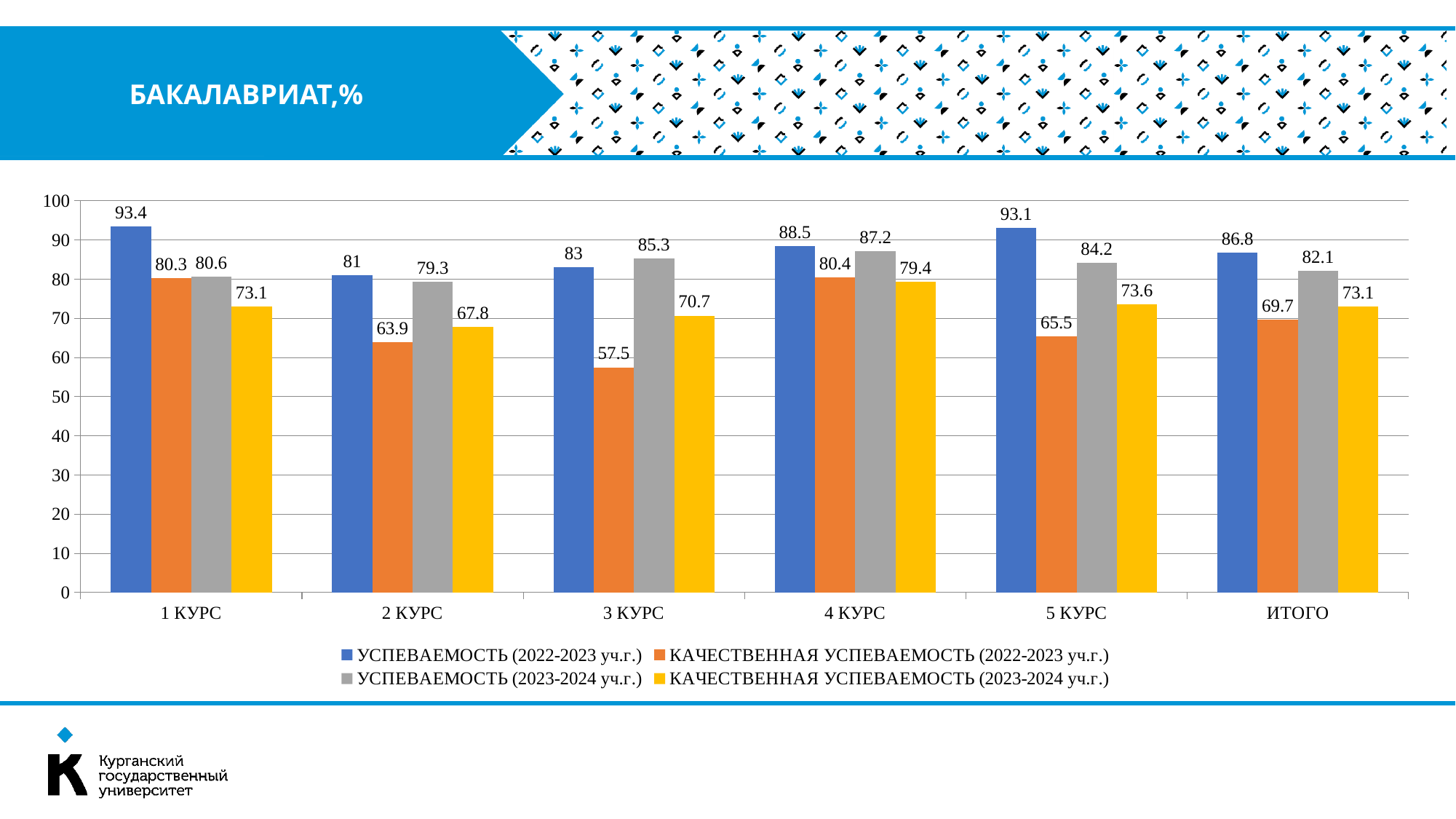
How many categories are shown on the x axis? 6 Is the value of КАЧЕСТВЕННАЯ УСПЕВАЕМОСТЬ (2022-2023 уч.г.) for 4 КУРС greater or less than 70? greater Which category has the highest value for УСПЕВАЕМОСТЬ (2023-2024 уч.г.)? 4 КУРС What is the value of УСПЕВАЕМОСТЬ (2022-2023 уч.г.) for 1 КУРС? 93.4 What is the title of the slide? БАКАЛАВРИАТ,% Which category has the lowest value for КАЧЕСТВЕННАЯ УСПЕВАЕМОСТЬ (2022-2023 уч.г.)? 3 КУРС What is the difference between УСПЕВАЕМОСТЬ (2022-2023 уч.г.) and КАЧЕСТВЕННАЯ УСПЕВАЕМОСТЬ (2022-2023 уч.г.) for 5 КУРС? 27.6 Which is larger for 2 КУРС: УСПЕВАЕМОСТЬ (2022-2023 уч.г.) or УСПЕВАЕМОСТЬ (2023-2024 уч.г.)? УСПЕВАЕМОСТЬ (2022-2023 уч.г.) What is the value of УСПЕВАЕМОСТЬ (2023-2024 уч.г.) for ИТОГО? 82.1 How many series does the legend list? 4 What is the value of КАЧЕСТВЕННАЯ УСПЕВАЕМОСТЬ (2023-2024 уч.г.) for 3 КУРС? 70.7 What kind of chart is shown on the slide? bar chart